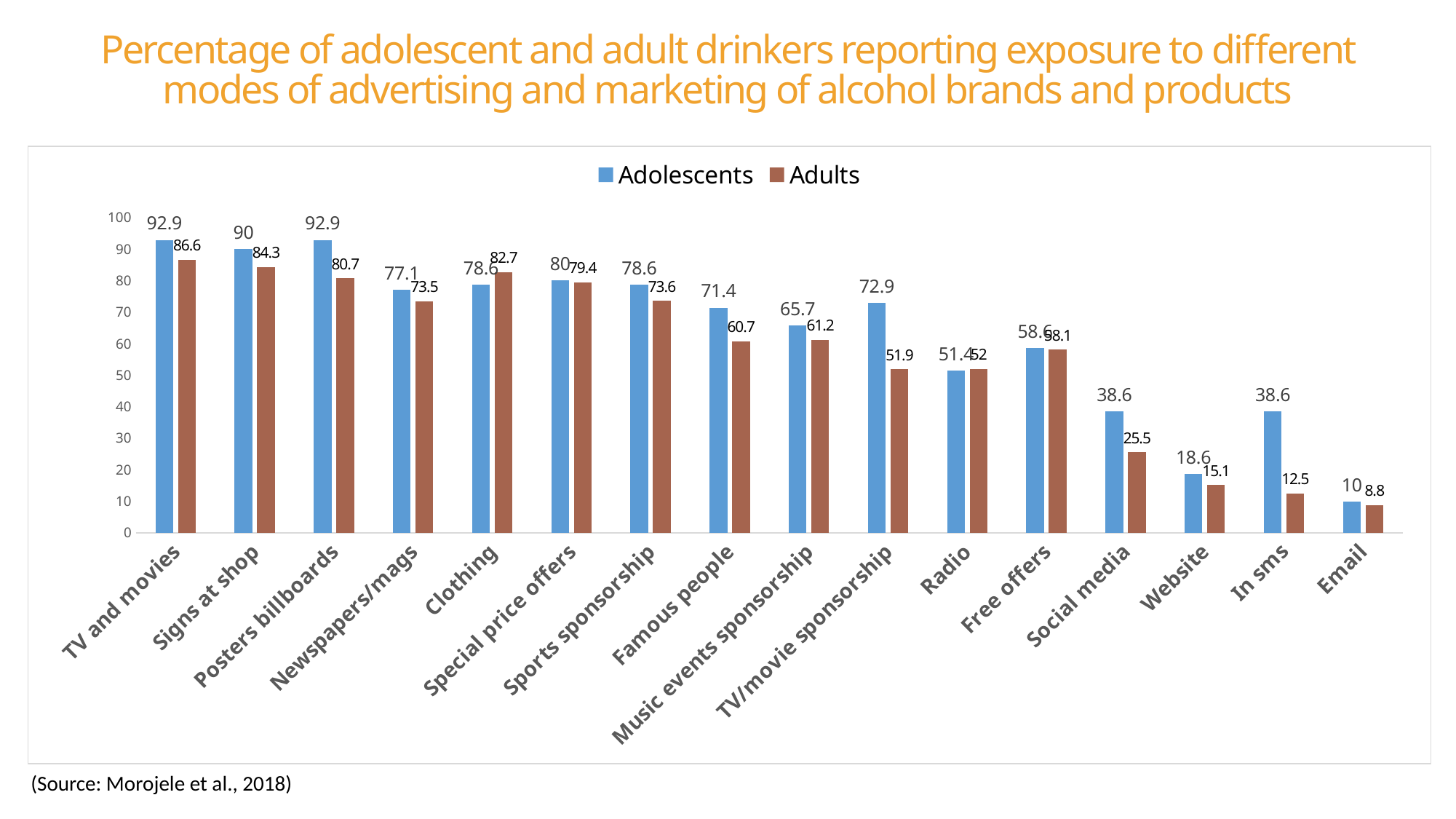
What is the Adults value for TV/movie sponsorship? 51.9 Which is larger for Clothing: the Adolescents value or the Adults value? Adults What percentage of adolescents reported exposure via Social media? 38.6 What kind of chart is shown on the slide? Bar chart How many modes of advertising are shown on the x axis? 16 What source is cited below the chart? Morojele et al., 2018 How many series does the legend list? 2 What percentage of adults reported exposure via Posters billboards? 80.7 What is the Adolescents value for Website? 18.6 Which mode of advertising has the highest Adults value? TV and movies What is the difference between the Adolescents and Adults values for In sms? 26.1 Which mode of advertising has the lowest Adolescents value? Email